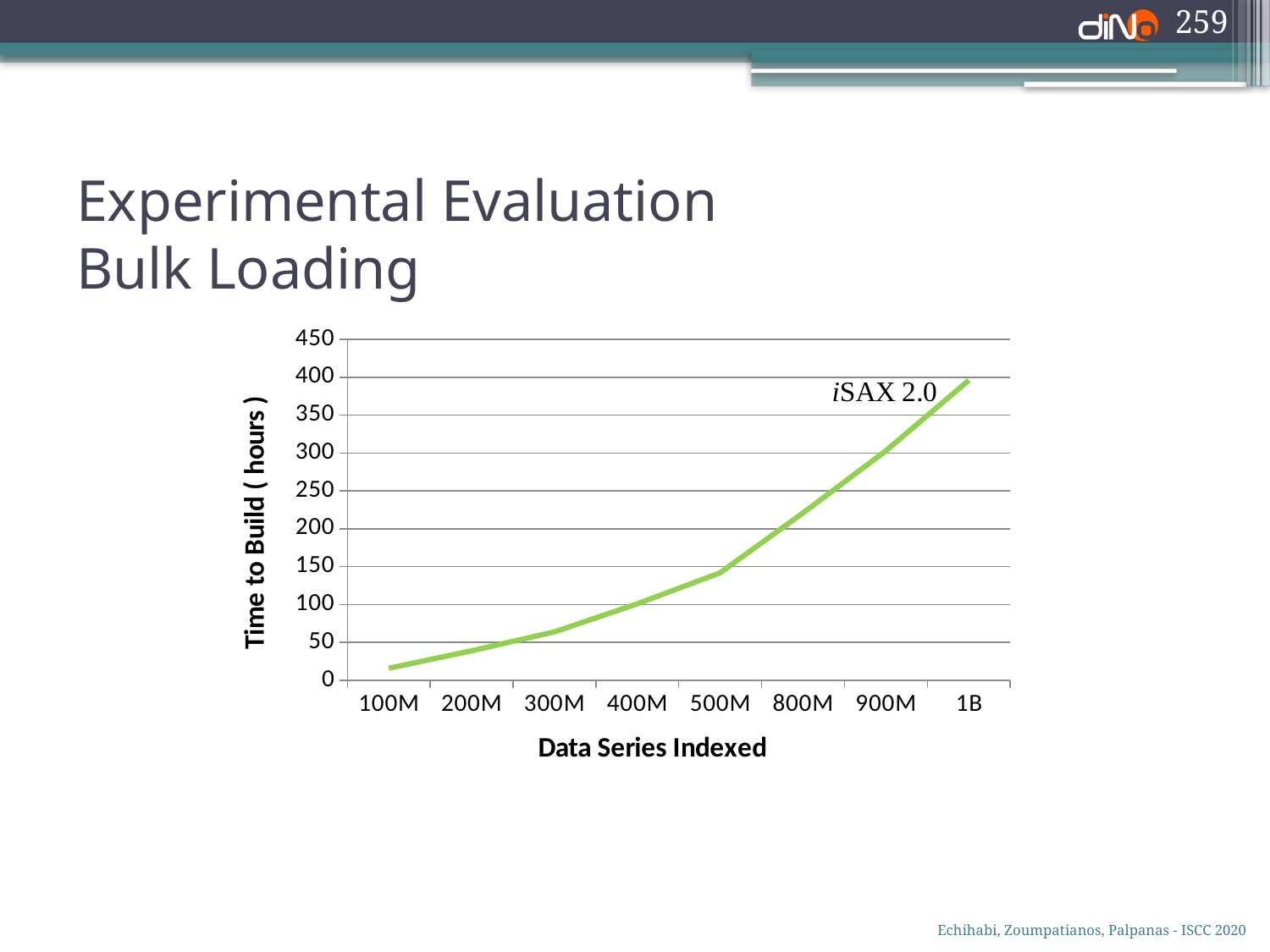
Which data series size has the lowest time to build? 100M What kind of chart is shown on the slide? line chart What is the label of the y axis of the chart? Time to Build ( hours ) Which data series size has the highest time to build? 1B Which has a larger time to build, 500M or 900M data series? 900M Is the time to build for 900M data series greater or less than 250 hours? greater Is the time to build for 1B data series greater or less than 350 hours? greater How many data series are plotted in the chart? 1 What is the name of the series plotted in the chart? iSAX 2.0 Does the time to build rise or fall as the number of data series indexed increases? rise How many categories are shown on the x axis of the chart? 8 Is the time to build for 100M data series greater or less than 50 hours? less